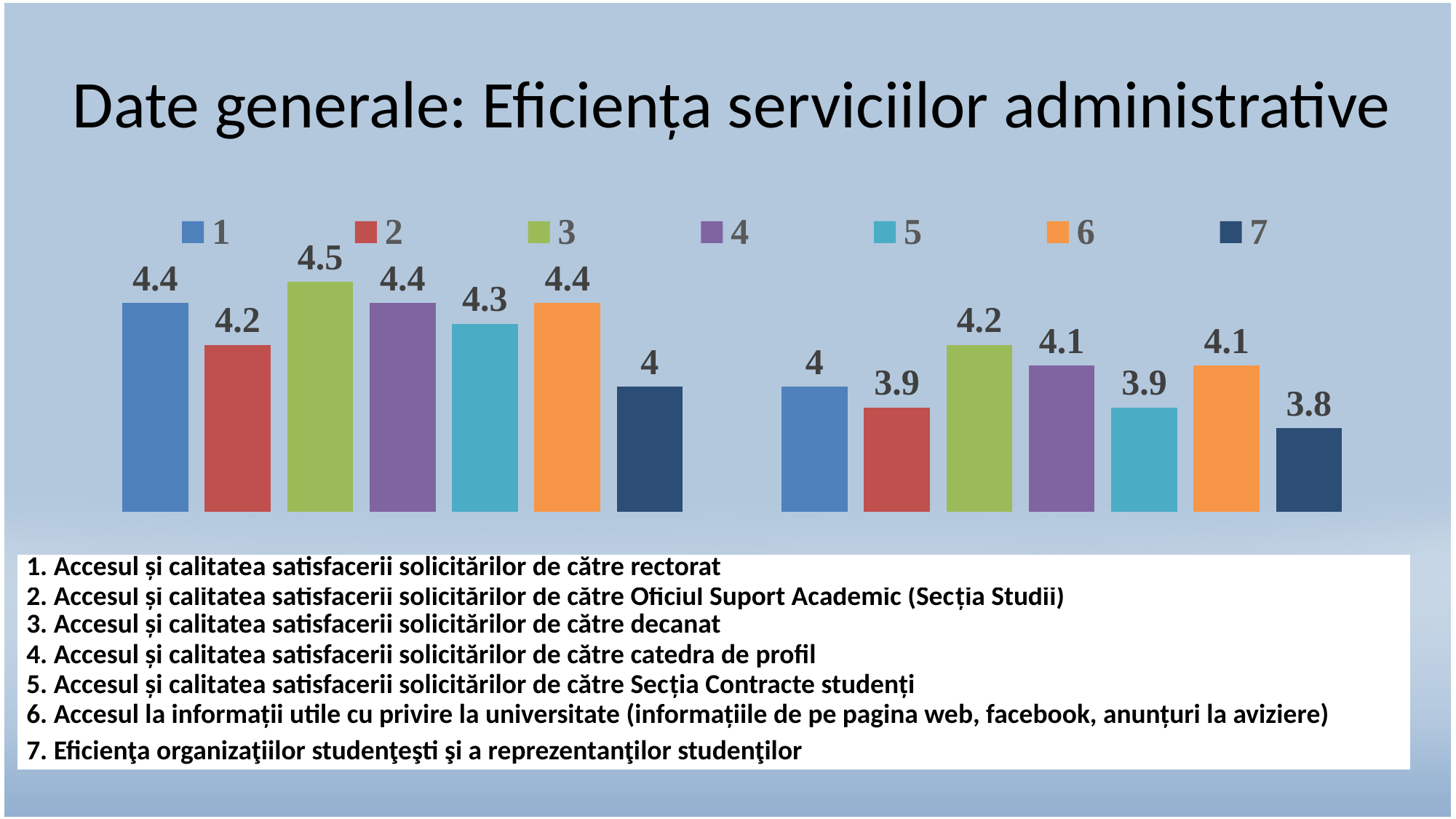
Which series has the highest value in the left group of bars? 3 What is the value of series 2 in the right group of bars? 3.9 What colour is the bar for series 6 in the legend? orange Which is larger: the value of series 3 in the right group or the value of series 7 in the right group? series 3 What is the difference between the value of series 1 in the left group and the value of series 1 in the right group? 0.4 How many series does the legend list? 7 What is the value of series 5 in the left group of bars? 4.3 What kind of chart is shown on the slide? bar chart What is the difference between the value of series 3 and the value of series 7 in the left group of bars? 0.5 What is the value of series 3 in the left group of bars? 4.5 Which series has the lowest value in the right group of bars? 7 What is the value of series 7 in the right group of bars? 3.8